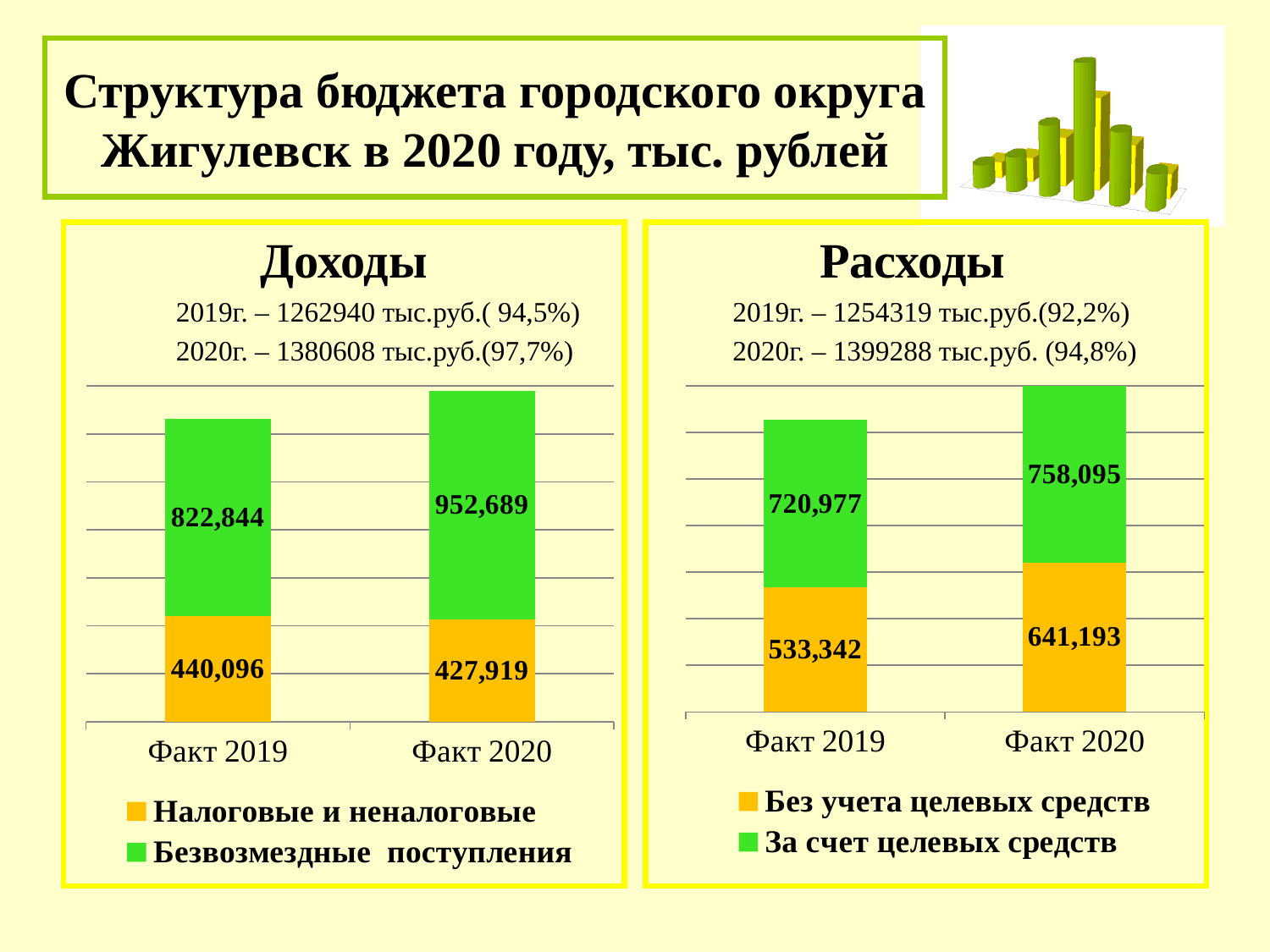
On the Расходы chart, what is the difference between Без учета целевых средств for Факт 2020 and Факт 2019? 107,851 On the Доходы chart, what is the total of the stacked bar for Факт 2020? 1380608 On the Расходы chart, what is the value of Без учета целевых средств for Факт 2019? 533,342 On the Доходы chart, which is larger: Налоговые и неналоговые for Факт 2019 or for Факт 2020? Факт 2019 On the Доходы chart, what is the value of Безвозмездные поступления for Факт 2019? 822,844 On the Расходы chart, what is the total of the stacked bar for Факт 2019? 1254319 How many series does the legend of the Расходы chart list? 2 On the Расходы chart, what is the value of За счет целевых средств for Факт 2020? 758,095 On the Расходы chart, which is larger: За счет целевых средств for Факт 2019 or Без учета целевых средств for Факт 2020? За счет целевых средств for Факт 2019 On the Доходы chart, what is the difference between Безвозмездные поступления for Факт 2020 and Факт 2019? 129,845 What kind of chart is the Доходы chart? Stacked bar chart On the Доходы chart, what is the value of Налоговые и неналоговые for Факт 2020? 427,919